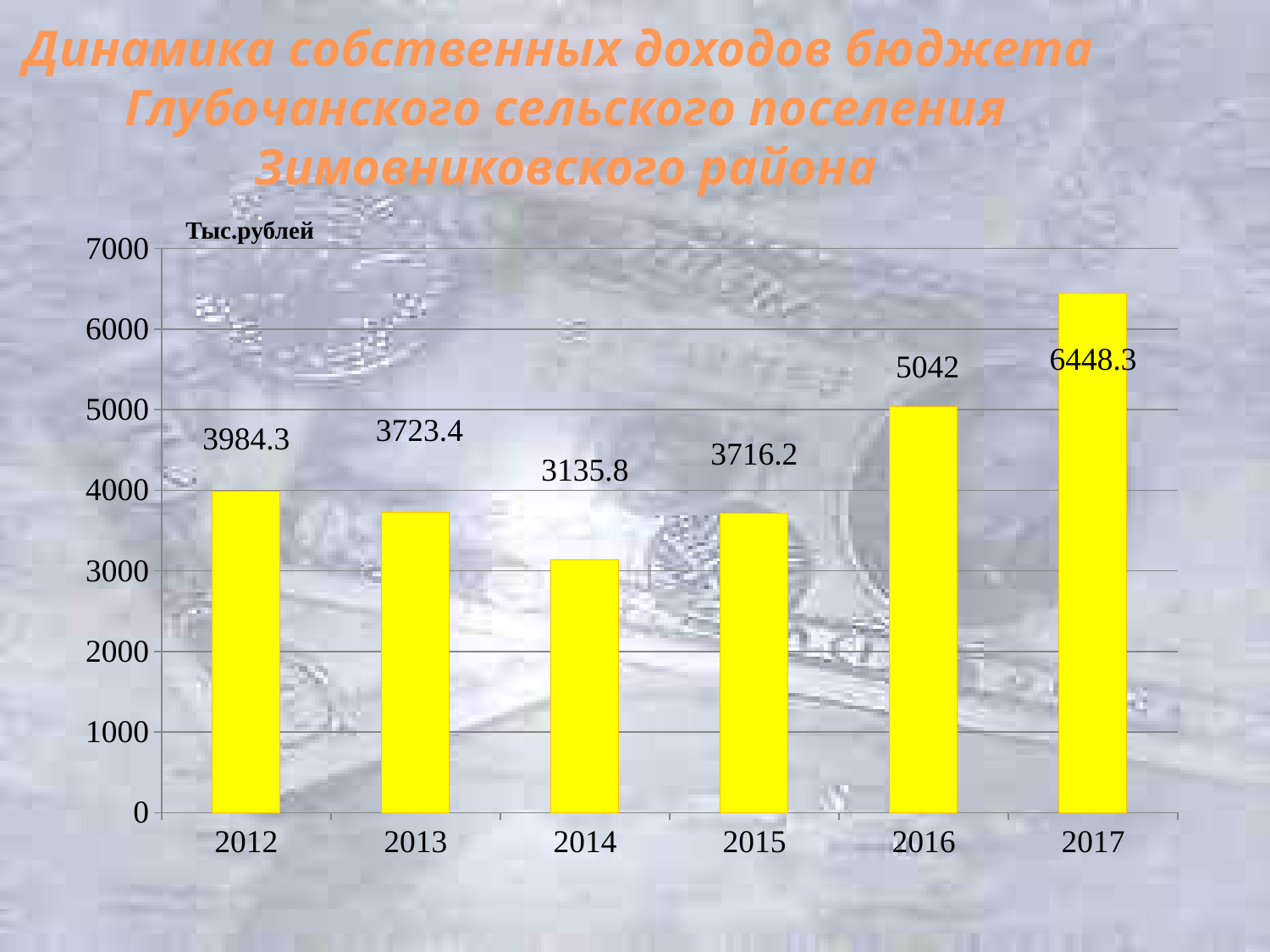
Which year has the lowest value? 2014 How many years are shown on the x axis? 6 Is the value for 2016 greater or less than 5000? greater What is the value for 2016? 5042 What unit label is shown above the vertical axis? Тыс.рублей Which year has the highest value? 2017 Which is larger, the value for 2012 or the value for 2015? 2012 What kind of chart is shown on the slide? bar chart What is the value for 2014? 3135.8 What is the value for 2017? 6448.3 What is the difference between the values for 2012 and 2014? 848.5 What is the difference between the values for 2017 and 2016? 1406.3